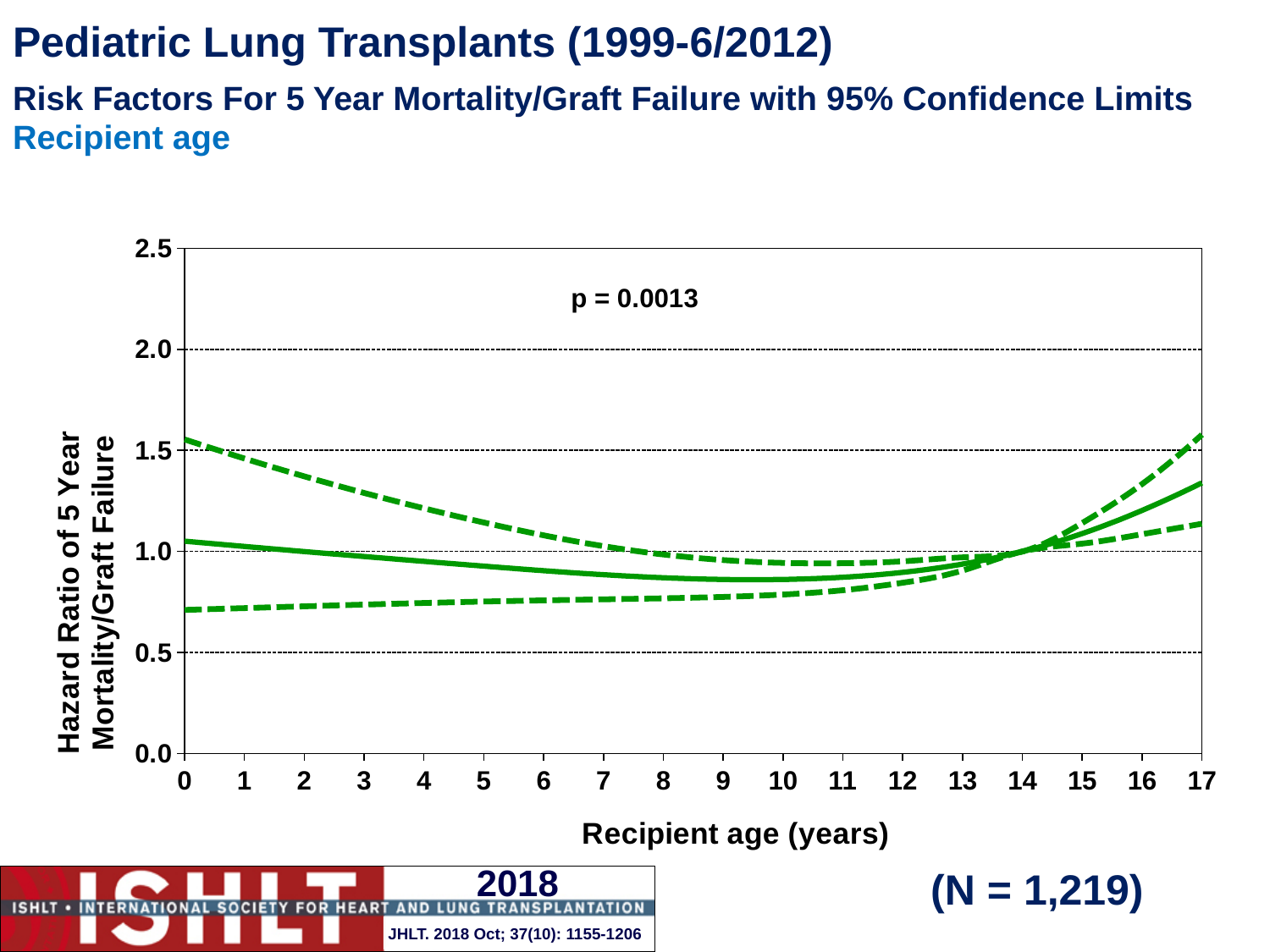
What kind of chart is shown on the slide? line chart What is the p-value shown on the chart? p = 0.0013 How many lines are plotted on the chart? 3 Is the value of the solid hazard ratio line at recipient age 10 greater or less than 1.0? less Is the value of the lower dashed confidence limit at recipient age 0 greater or less than 0.5? greater What is the label of the x axis? Recipient age (years) Is the value of the lower dashed confidence limit at recipient age 17 greater or less than 1.0? greater Does the solid hazard ratio line rise or fall between recipient age 0 and recipient age 10? fall Does the solid hazard ratio line rise or fall between recipient age 10 and recipient age 17? rise What is the sample size (N) shown on the slide? N = 1,219